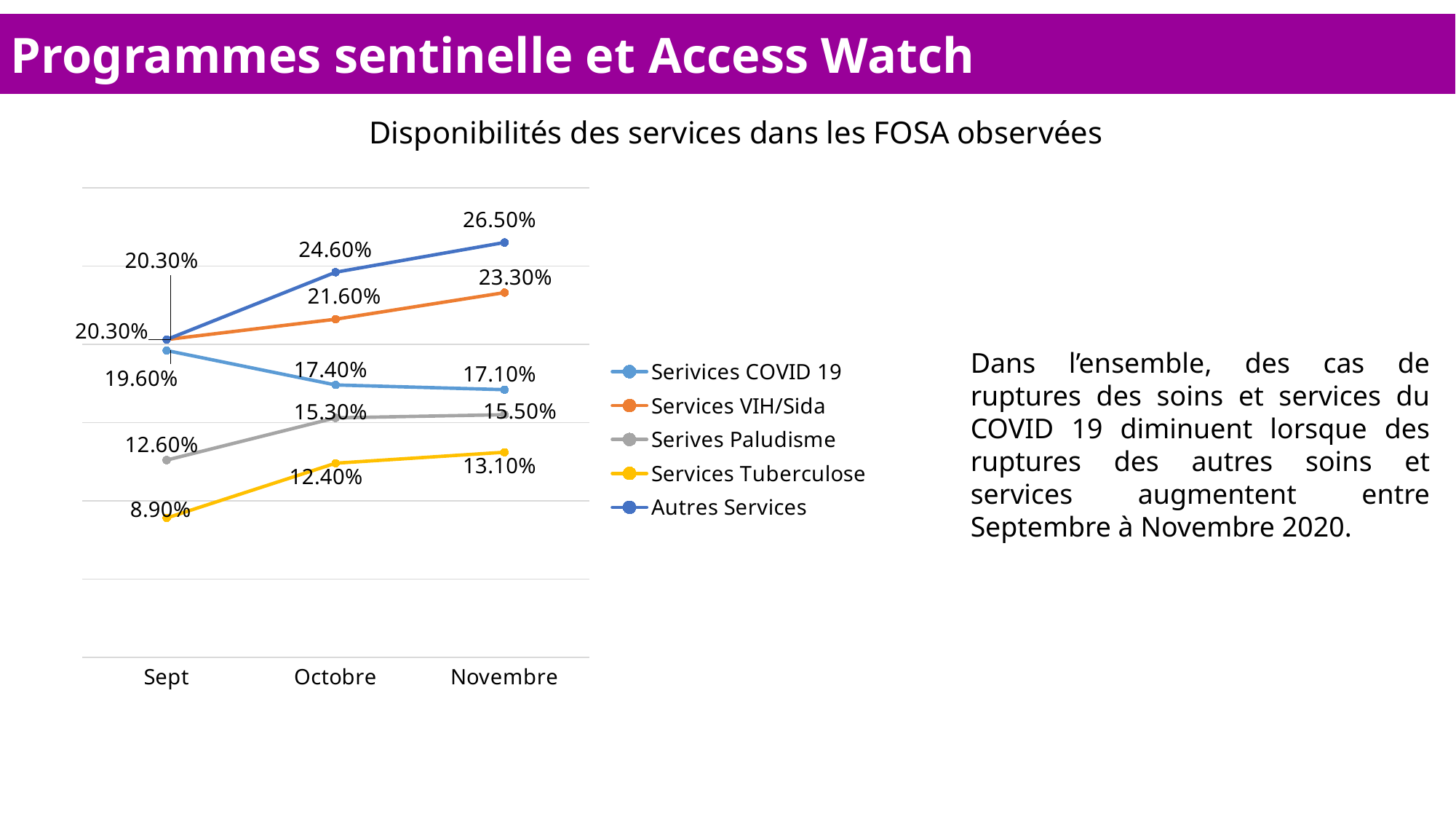
What is the difference between Autres Services and Services VIH/Sida in Novembre? 3.20% What is the value for Services Tuberculose in Sept? 8.90% What is the value for Autres Services in Novembre? 26.50% How many series does the legend list? 5 What is the value for Services VIH/Sida in Octobre? 21.60% What kind of chart is shown on the slide? line chart How many points along the x axis does each line have? 3 Which series has the highest value in Novembre? Autres Services Which is larger in Octobre: Serivices COVID 19 or Serives Paludisme? Serivices COVID 19 Do the values for Serivices COVID 19 rise or fall from Sept to Novembre? fall What is the title of the chart? Disponibilités des services dans les FOSA observées Which series has the lowest value in Sept? Services Tuberculose